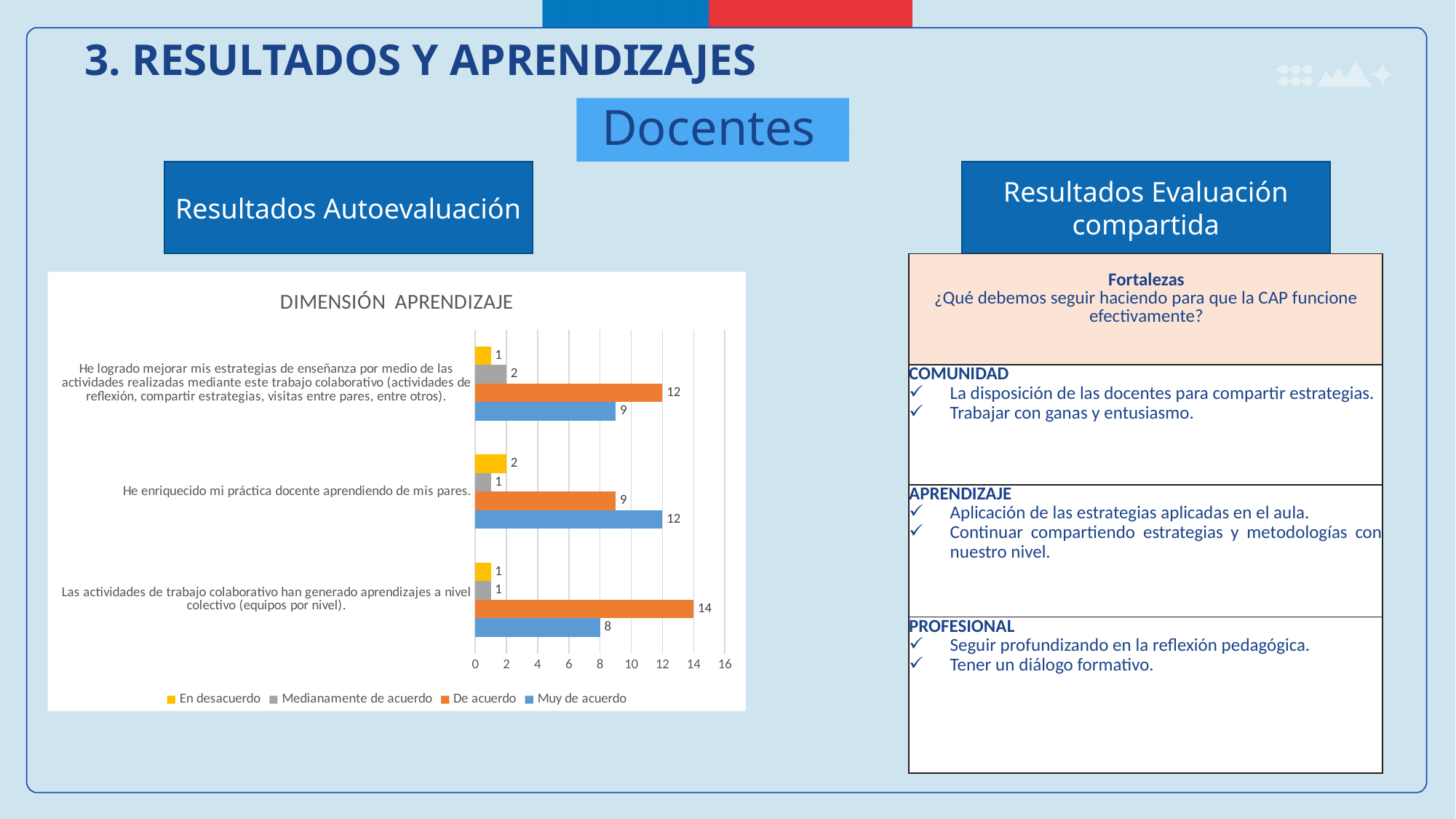
In the "DIMENSIÓN APRENDIZAJE" chart, which statement has the lowest "Muy de acuerdo" value? Las actividades de trabajo colaborativo han generado aprendizajes a nivel colectivo (equipos por nivel). How many statements (categories) are plotted in the "DIMENSIÓN APRENDIZAJE" chart? 3 In the "DIMENSIÓN APRENDIZAJE" chart, what colour represents the "En desacuerdo" series? Yellow In the "DIMENSIÓN APRENDIZAJE" chart, what is the "Muy de acuerdo" value for "He enriquecido mi práctica docente aprendiendo de mis pares."? 12 What kind of chart is shown under "Resultados Autoevaluación"? Bar chart In the "DIMENSIÓN APRENDIZAJE" chart, what is the "Medianamente de acuerdo" value for "He logrado mejorar mis estrategias de enseñanza por medio de las actividades realizadas mediante este trabajo colaborativo"? 2 What is the title of the chart on the slide? DIMENSIÓN APRENDIZAJE How many series does the legend of the "DIMENSIÓN APRENDIZAJE" chart list? 4 In the "DIMENSIÓN APRENDIZAJE" chart, which statement has the highest "De acuerdo" value? Las actividades de trabajo colaborativo han generado aprendizajes a nivel colectivo (equipos por nivel). In the "DIMENSIÓN APRENDIZAJE" chart, for "He enriquecido mi práctica docente aprendiendo de mis pares.", which is larger: "De acuerdo" or "Muy de acuerdo"? Muy de acuerdo In the "DIMENSIÓN APRENDIZAJE" chart, what is the difference between the "De acuerdo" and "Muy de acuerdo" values for "Las actividades de trabajo colaborativo han generado aprendizajes a nivel colectivo (equipos por nivel)."? 6 In the "DIMENSIÓN APRENDIZAJE" chart, what is the "De acuerdo" value for "Las actividades de trabajo colaborativo han generado aprendizajes a nivel colectivo (equipos por nivel)."? 14